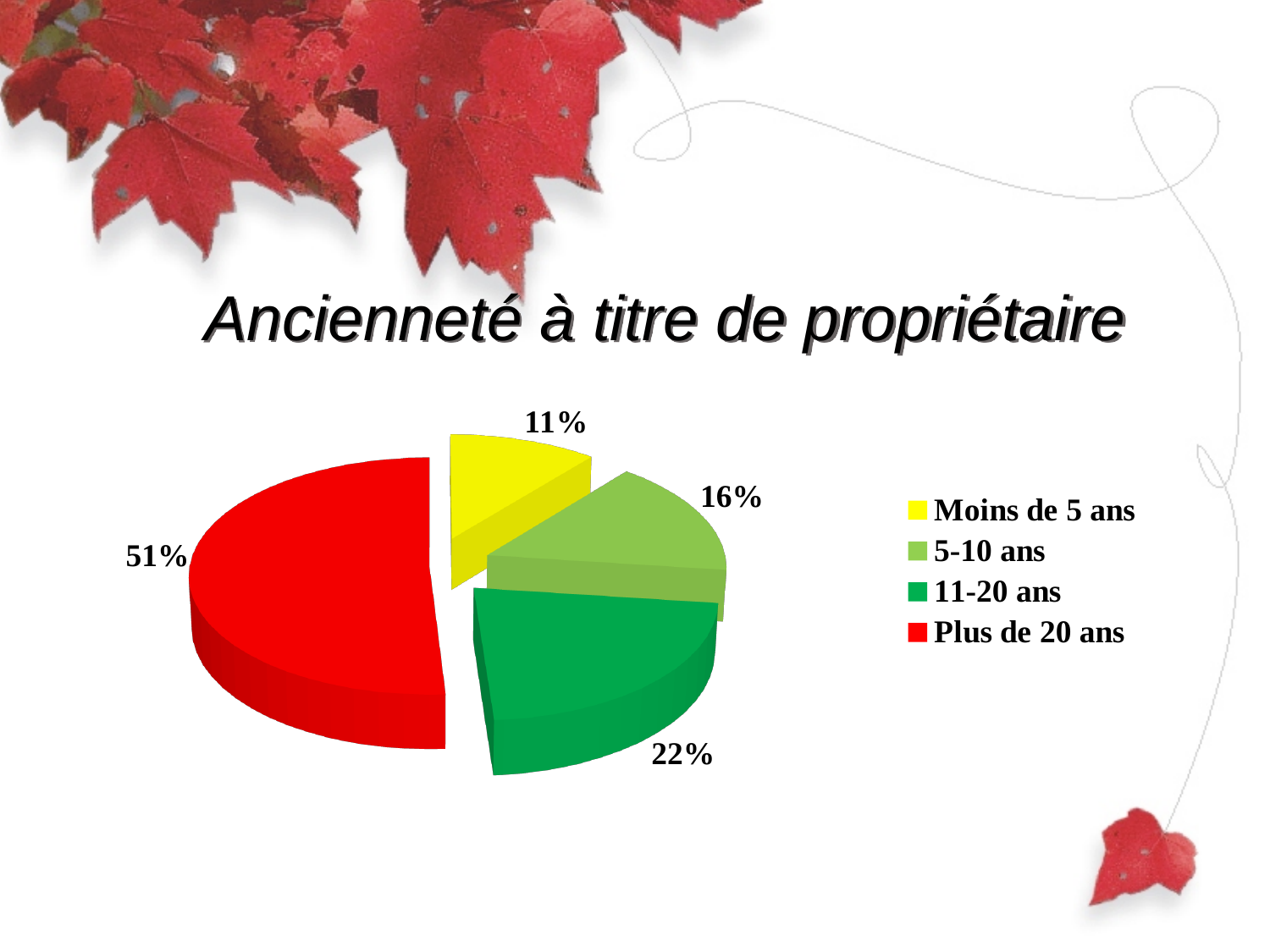
What is the value shown for "11-20 ans"? 22% What is the difference between the shares of "Plus de 20 ans" and "11-20 ans"? 29% What share of the pie does "Plus de 20 ans" represent? 51% Which category has the smallest slice of the pie? Moins de 5 ans What kind of chart is shown on the slide? Pie chart How many categories does the pie chart show? 4 What is the value shown for "Moins de 5 ans"? 11% Which is larger, the share for "11-20 ans" or the share for "5-10 ans"? 11-20 ans What is the value shown for "5-10 ans"? 16% What is the difference between the shares of "5-10 ans" and "Moins de 5 ans"? 5% What colour is the slice for "Plus de 20 ans"? Red Which category has the largest slice of the pie? Plus de 20 ans